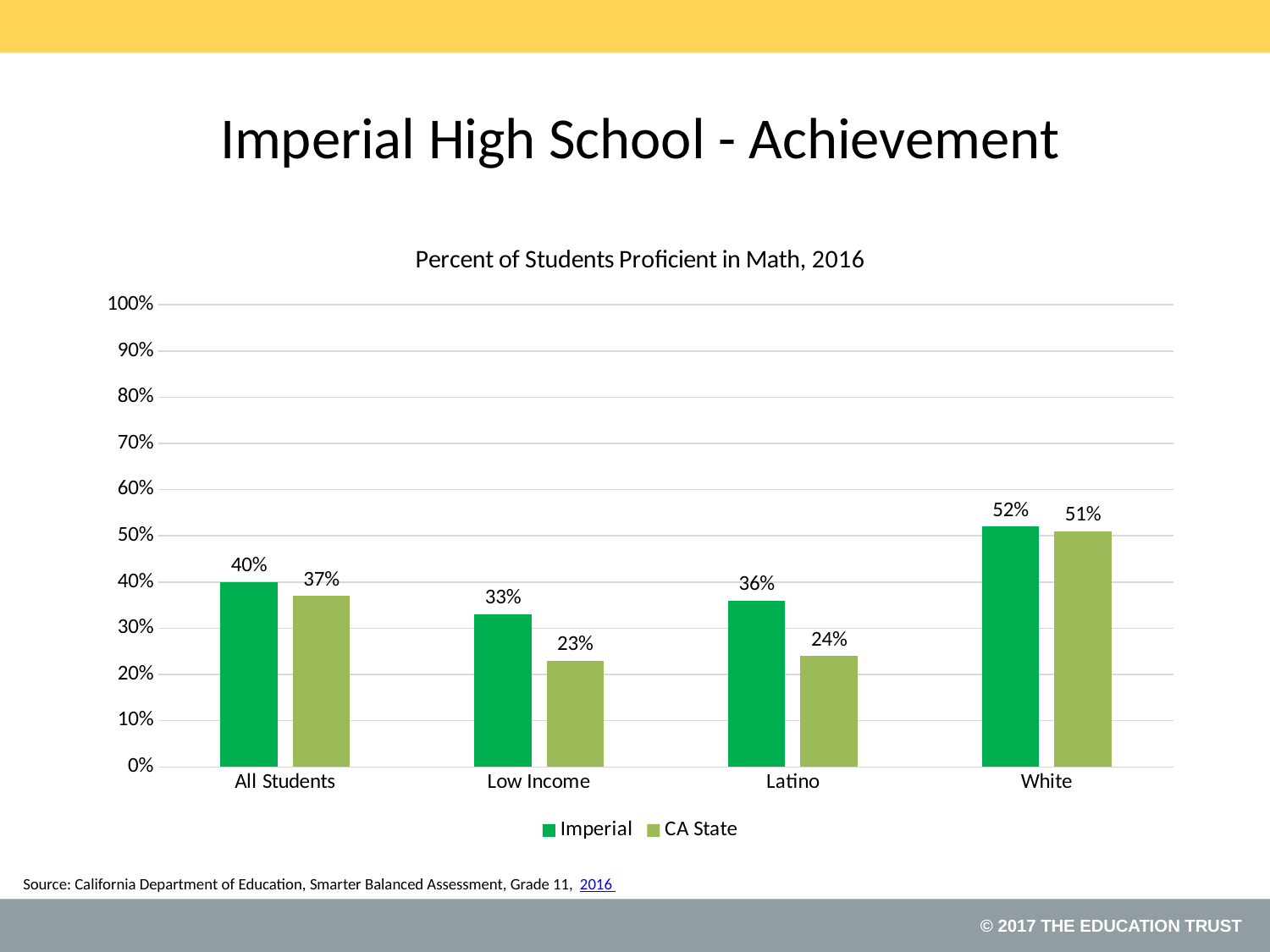
What is the Imperial value for Low Income? 33% Which is larger for Low Income, the Imperial value or the CA State value? Imperial How many categories are shown on the x axis? 4 What is the CA State value for Latino? 24% What is the difference between the Imperial and CA State values for Latino? 12% What is the Imperial value for White? 52% How many series does the legend list? 2 What kind of chart is shown on the slide? Bar chart Which category has the lowest Imperial value? Low Income Is the CA State value for All Students greater or less than 30%? greater What is the title of the chart? Percent of Students Proficient in Math, 2016 Which category has the highest CA State value? White